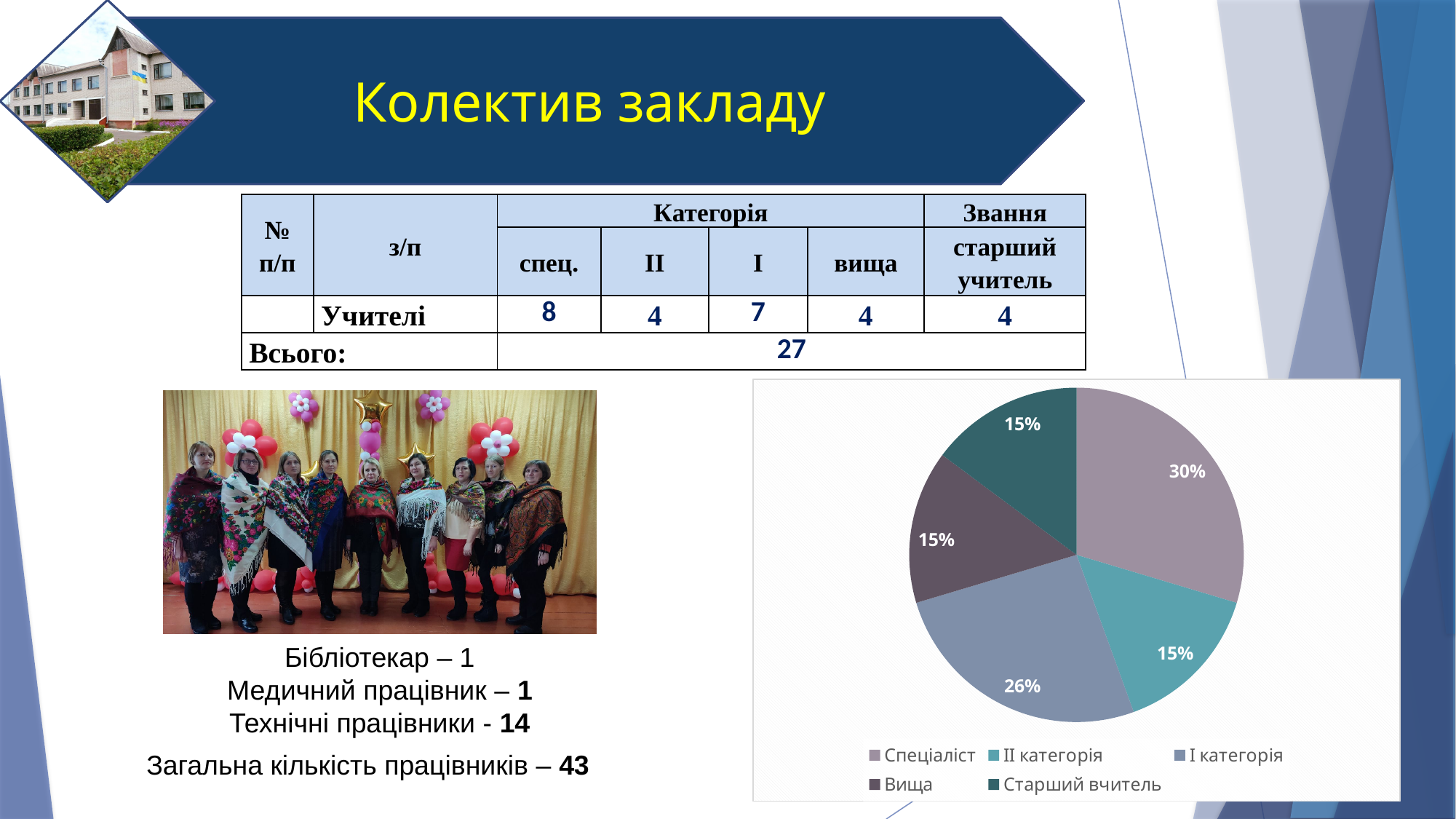
What share of the pie chart does Вища represent? 15% What share of the pie chart does Спеціаліст represent? 30% What share of the pie chart does I категорія represent? 26% What is the difference between the Спеціаліст and Вища shares in the pie chart? 15% What is the difference between the Спеціаліст and I категорія shares in the pie chart? 4% What kind of chart is shown on the slide? pie chart How many entries does the pie chart legend list? 5 How many slices does the pie chart have? 5 Which is larger in the pie chart, Спеціаліст or I категорія? Спеціаліст Which category has the largest slice in the pie chart? Спеціаліст